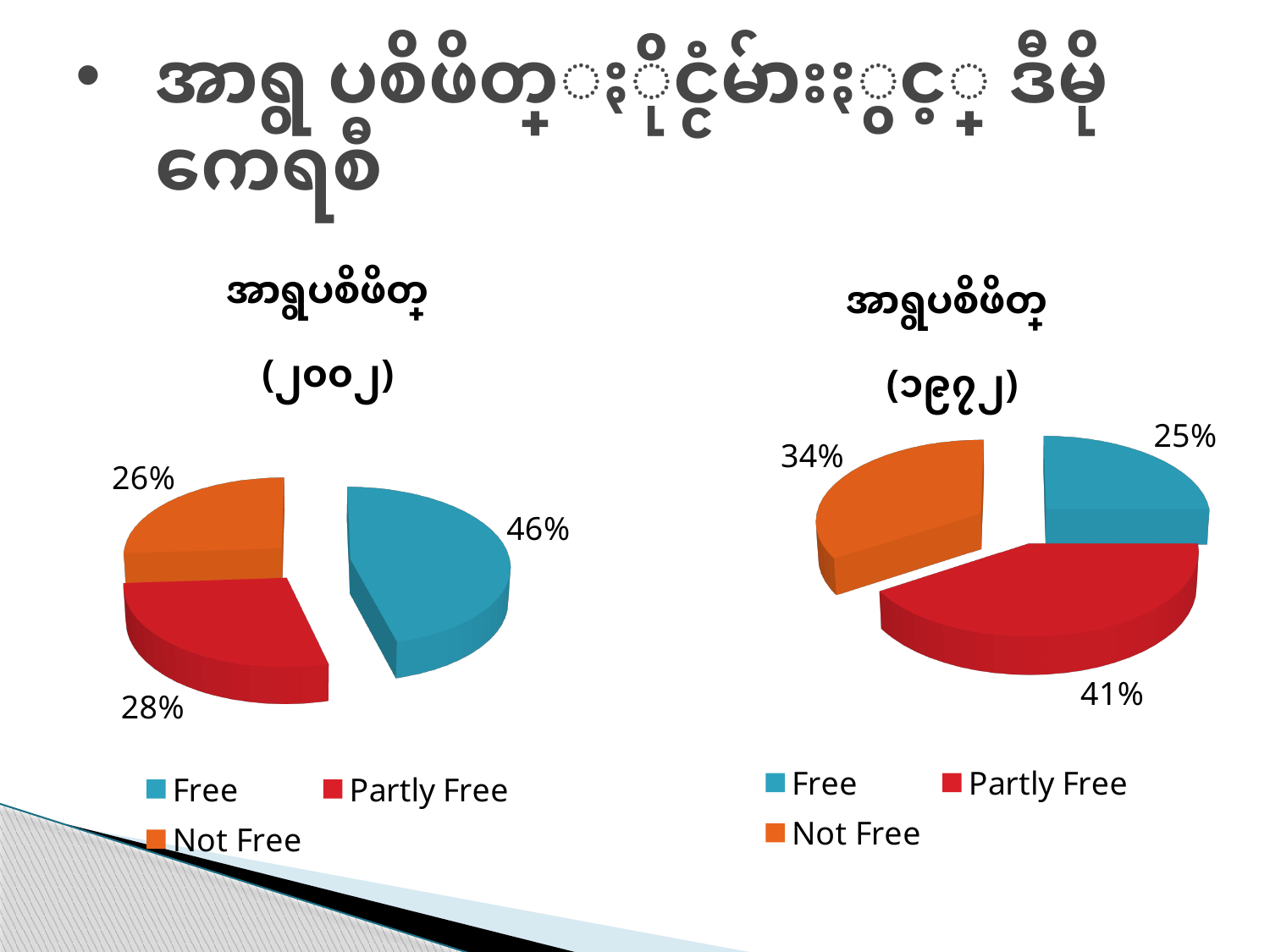
In the left pie chart, what share is labelled for the Free slice? 46% Which is larger in the left pie chart: the Partly Free slice or the Not Free slice? Partly Free In the right pie chart, what is the difference between the Partly Free and Not Free shares? 7% In the right pie chart, what share is labelled for the Free slice? 25% What type of chart is shown on the left of the slide? Pie chart How many categories does the legend of the right pie chart list? 3 In the left pie chart, what share is labelled for the Partly Free slice? 28% In the left pie chart, which category has the largest slice? Free In the left pie chart, what share is labelled for the Not Free slice? 26% In the right pie chart, which category has the smallest slice? Free In the right pie chart, what share is labelled for the Partly Free slice? 41% In the right pie chart, what share is labelled for the Not Free slice? 34%